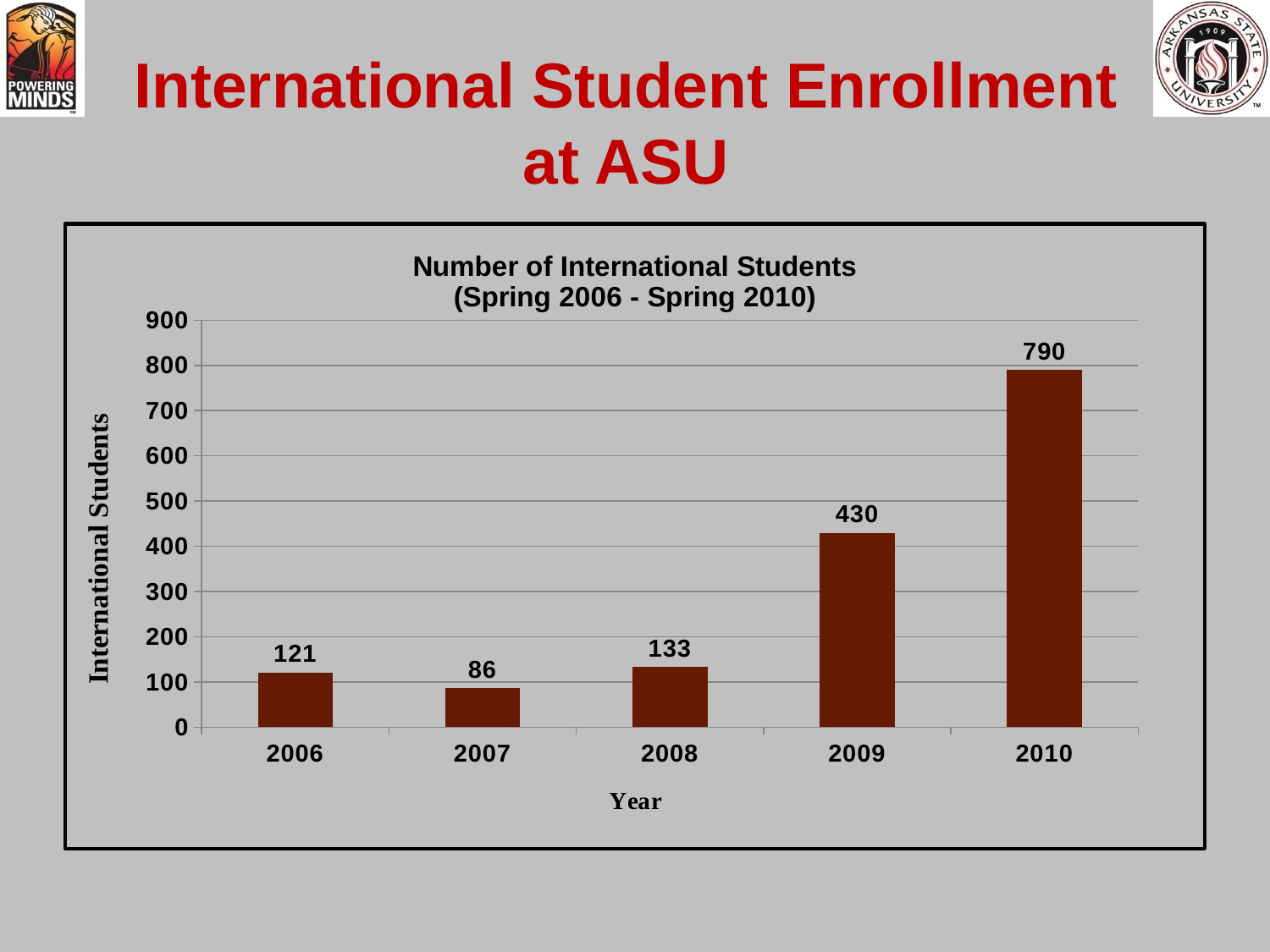
What is the difference in international students between 2008 and 2006? 12 What is the number of international students in 2010? 790 What is the number of international students in 2007? 86 What kind of chart is shown on the slide? Bar chart Is the value for 2009 greater or less than 400? greater What is the difference in international students between 2010 and 2009? 360 What is the title of the chart? Number of International Students (Spring 2006 - Spring 2010) Which year has the lowest number of international students? 2007 What is the number of international students in 2009? 430 Which year has the highest number of international students? 2010 Which year had more international students, 2006 or 2008? 2008 How many years are shown on the x axis of the chart? 5